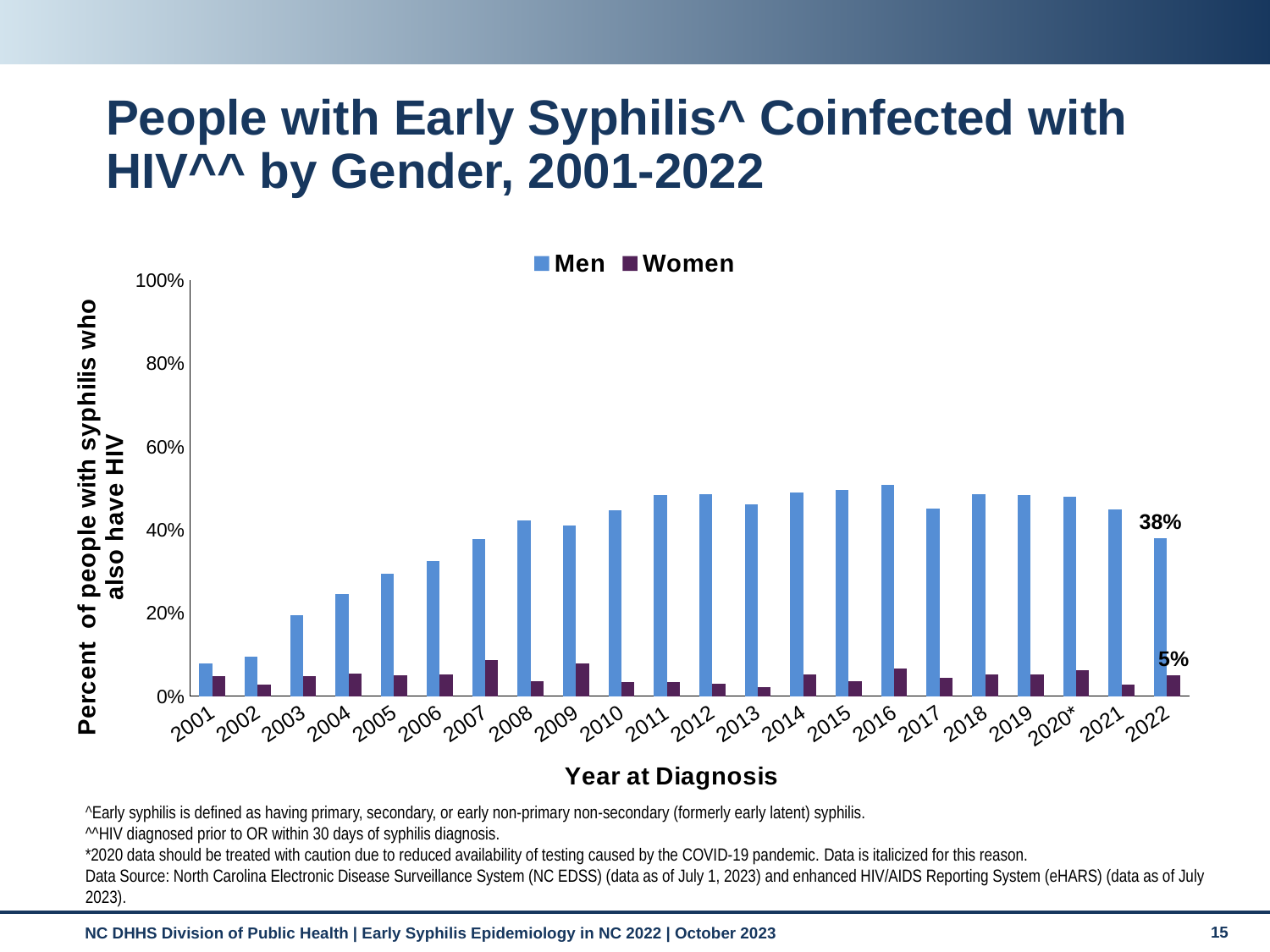
What kind of chart is shown on the slide? Bar chart Between 2001 and 2011, do the values for Men generally rise or fall? Rise What percentage of men with early syphilis also had HIV in 2022? 38% What is the title of the x axis? Year at Diagnosis What is the difference between the Men and Women values in 2022? 33 percentage points Is the value for Men in 2016 greater or less than 40%? greater In 2022, which group had the higher percentage coinfected with HIV, Men or Women? Men How many series does the legend list? 2 Is the value for Women in 2007 greater or less than 20%? less How many years are shown on the x axis of the chart? 22 What percentage of women with early syphilis also had HIV in 2022? 5% Is the value for Men in 2001 greater or less than 20%? less